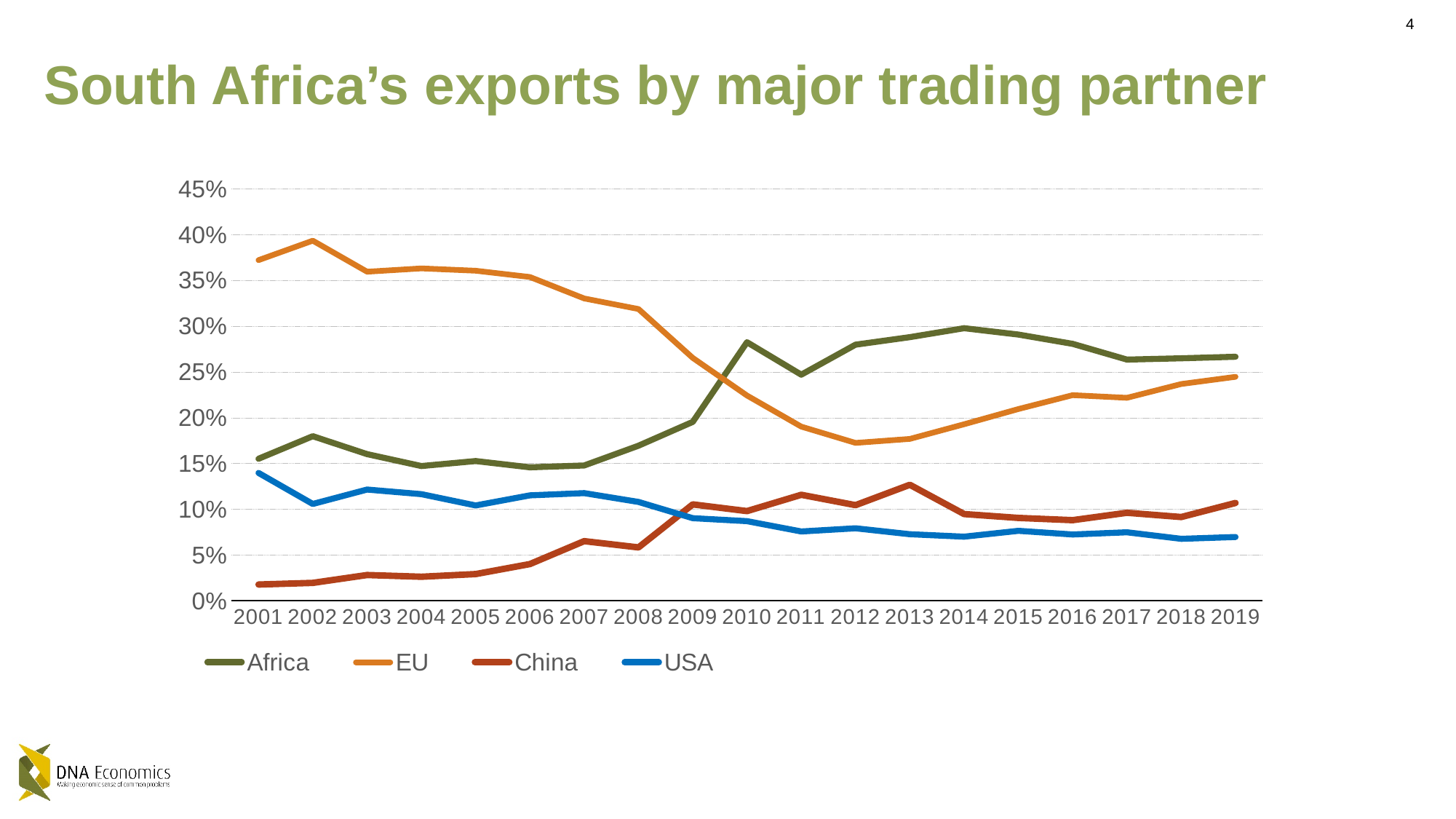
What kind of chart is shown on the slide? line chart Which trading partner had the highest share of South Africa's exports in 2019? Africa In 2010, which is larger: the share for Africa or the share for EU? Africa Is the value for EU in 2002 greater or less than 35%? greater How many years are shown along the x axis? 19 Is the value for Africa in 2014 greater or less than 25%? greater How many series does the legend list? 4 Which trading partner had the highest share of South Africa's exports in 2001? EU Is the value for China in 2001 greater or less than 5%? less Which trading partner had the lowest share of South Africa's exports in 2001? China Does the EU share rise or fall between 2002 and 2012? fall What is the title of the chart on the slide? South Africa's exports by major trading partner